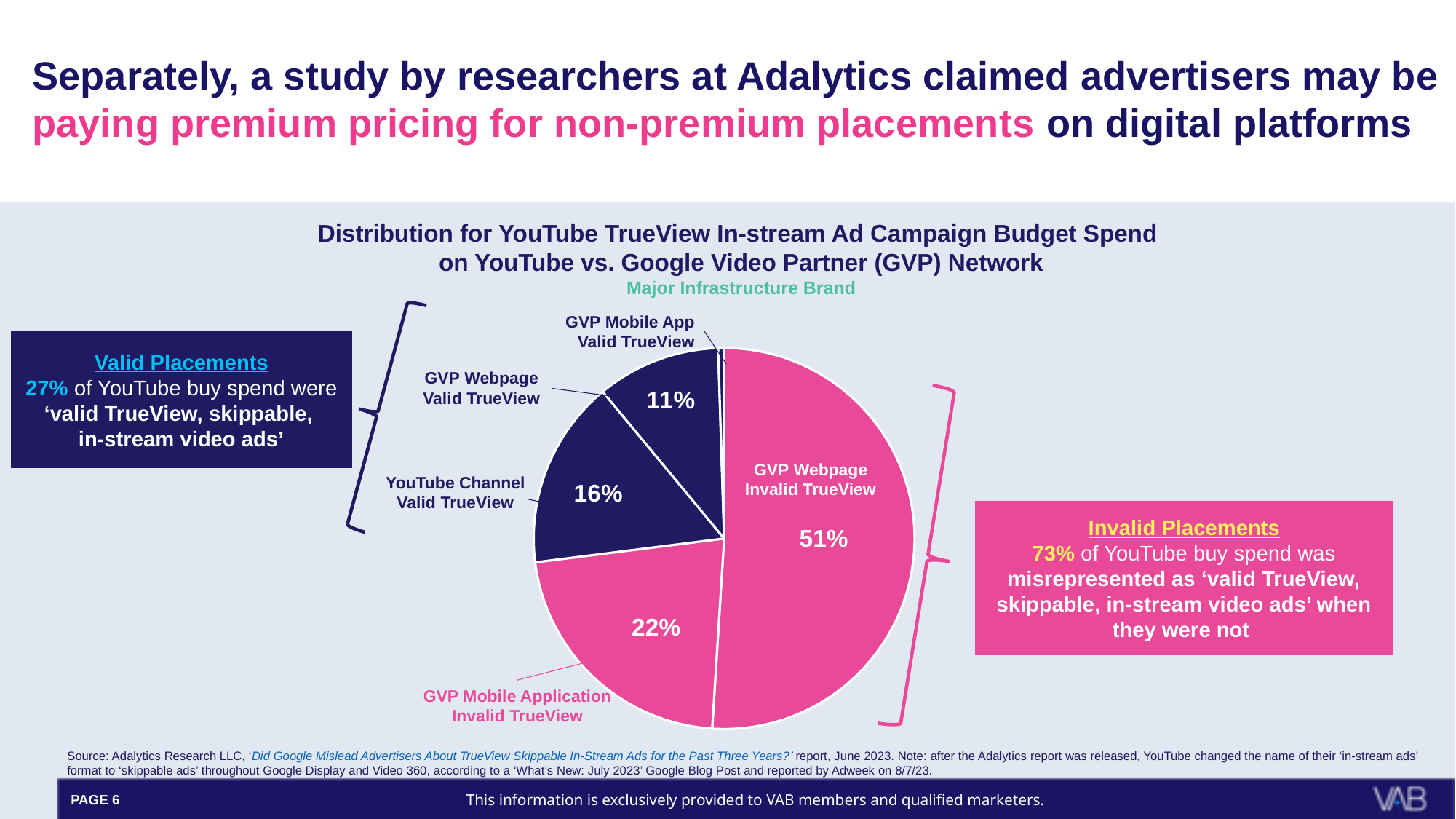
Which brand category is named in the subtitle beneath the chart title? Major Infrastructure Brand How many slices does the pie chart have? 5 What is the value shown for YouTube Channel Valid TrueView? 16% What is the value shown for GVP Webpage Valid TrueView? 11% Which is larger: YouTube Channel Valid TrueView or GVP Webpage Valid TrueView? YouTube Channel Valid TrueView What is the combined share of the two Invalid TrueView slices (GVP Webpage and GVP Mobile Application)? 73% Which slice of the pie is the smallest? GVP Mobile App Valid TrueView What is the difference between the GVP Webpage Invalid TrueView share and the GVP Mobile Application Invalid TrueView share? 29 percentage points Which slice of the pie is the largest? GVP Webpage Invalid TrueView What share of the pie does GVP Webpage Invalid TrueView account for? 51% What kind of chart is shown on the slide? pie chart What is the value shown for GVP Mobile Application Invalid TrueView? 22%